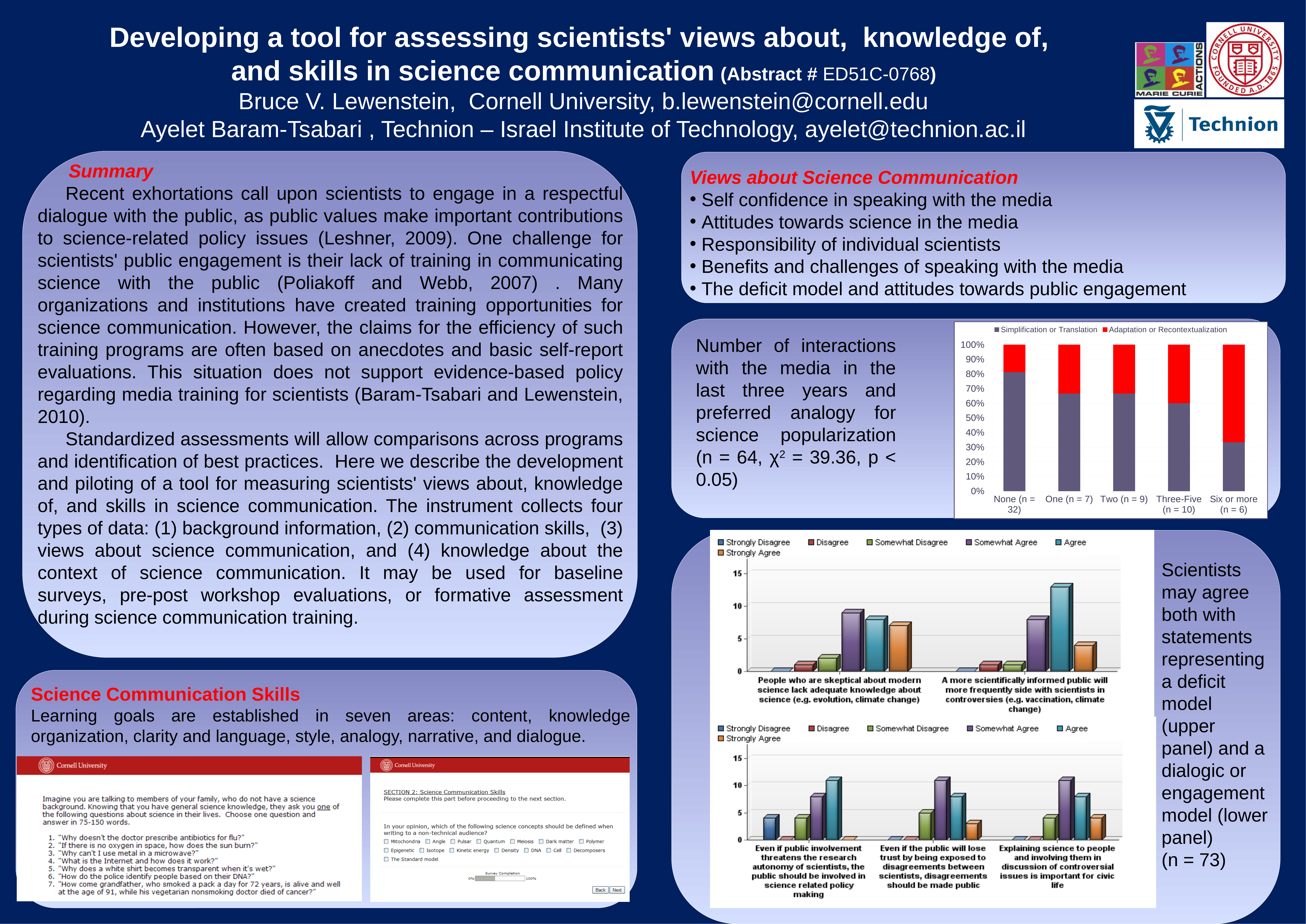
In the lower panel chart about the dialogic or engagement model statements, how many statements are shown on the x axis? 3 In the stacked bar chart about number of interactions with the media, what colour represents 'Adaptation or Recontextualization'? red What kind of chart is the lower panel chart about the dialogic or engagement model statements? bar chart In the upper panel chart about the deficit model statements, how many series does the legend list? 6 In the stacked bar chart about number of interactions with the media, how many series does the legend list? 2 In the upper panel chart about the deficit model statements, which response has the highest count for the statement 'A more scientifically informed public will more frequently side with scientists in controversies'? Agree In the stacked bar chart about number of interactions with the media, which category has the largest 'Adaptation or Recontextualization' share? Six or more (n = 6) In the stacked bar chart about number of interactions with the media, is the 'Simplification or Translation' share for 'None (n = 32)' greater or less than 70%? greater In the stacked bar chart about number of interactions with the media, is the 'Simplification or Translation' share for 'Six or more (n = 6)' greater or less than 50%? less In the stacked bar chart about number of interactions with the media, how many categories are shown on the x axis? 5 In the lower panel chart about the dialogic or engagement model statements, which response has the highest count for the statement 'Explaining science to people and involving them in discussion of controversial issues is important for civic life'? Somewhat Agree In the stacked bar chart about number of interactions with the media, does the 'Simplification or Translation' share rise or fall as the number of interactions increases from 'None' to 'Six or more'? fall